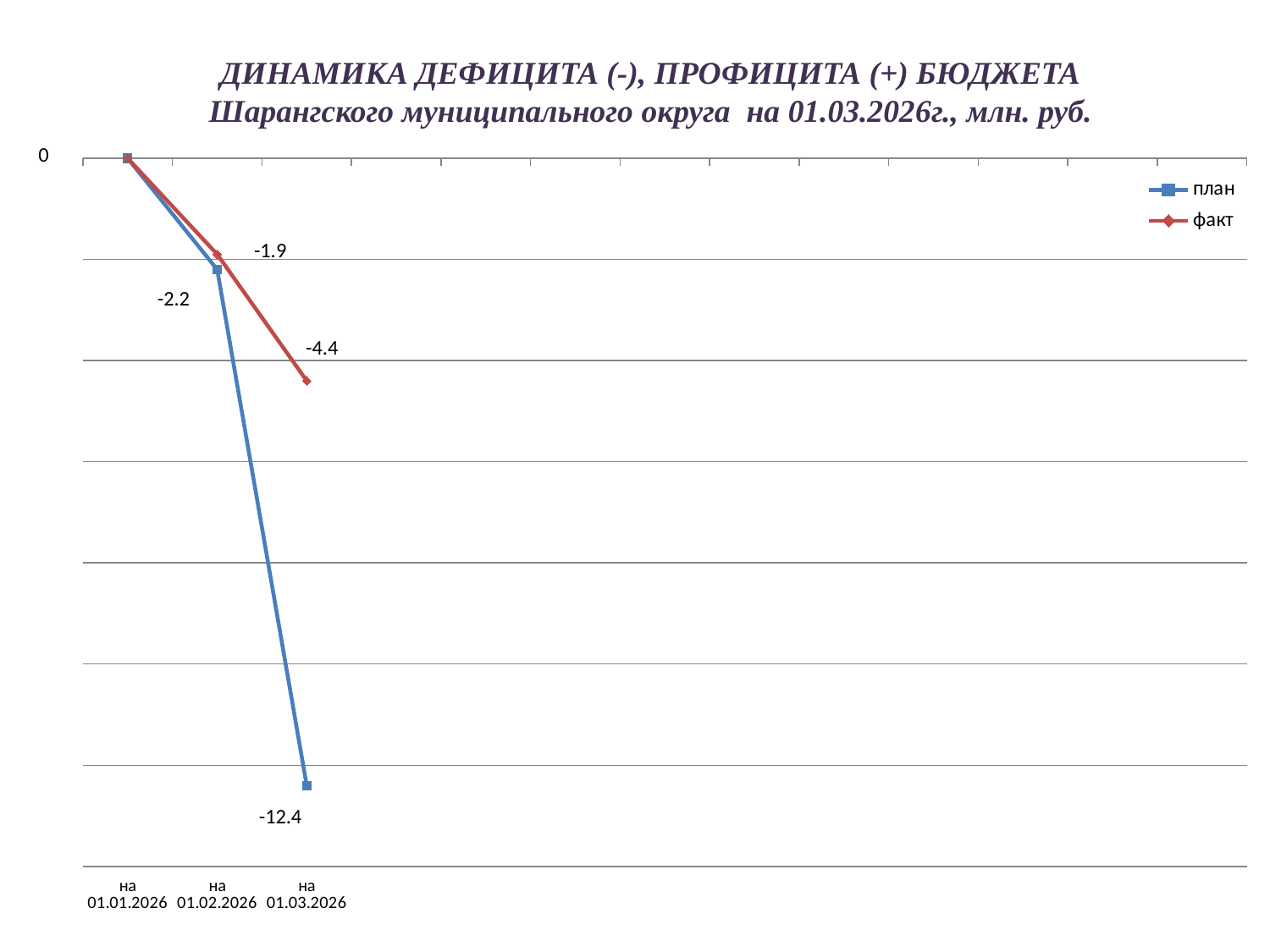
Is the value of факт on 01.03.2026 greater or less than 0? less What is the difference between the план and факт values on 01.03.2026? 8 Do the план values rise or fall from 01.01.2026 to 01.03.2026? fall What is the value of факт on 01.03.2026? -4.4 How many dates are plotted along the x axis? 3 What is the value of план on 01.02.2026? -2.2 How many series does the legend list? 2 What are the two series named in the legend? план and факт What kind of chart is shown on the slide? line chart What is the value of план on 01.03.2026? -12.4 What is the value of факт on 01.02.2026? -1.9 Which series has the lower value on 01.03.2026, план or факт? план